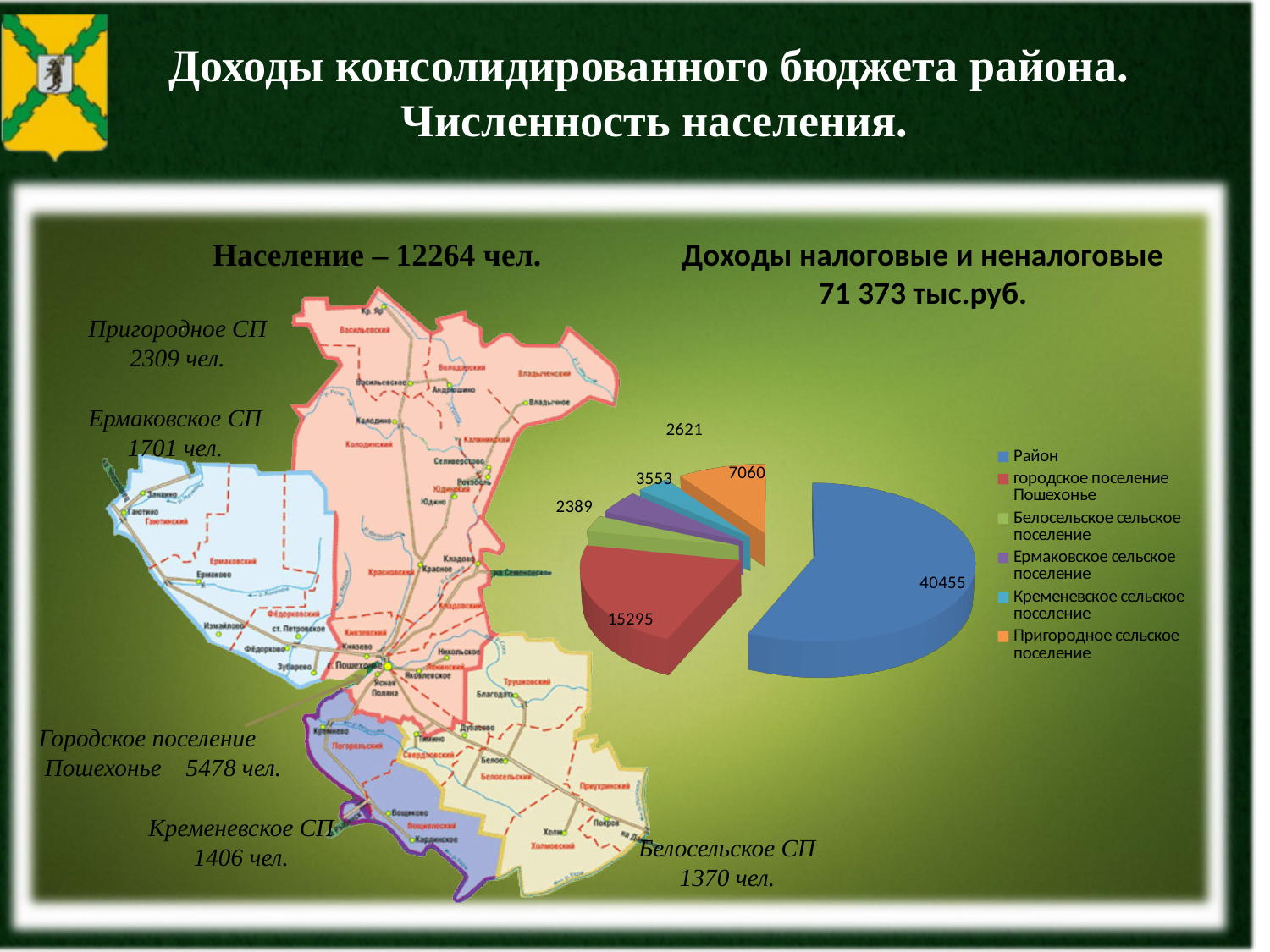
What is the value for городское поселение Пошехонье in the pie chart? 15295 Which is larger: the value for Кременевское сельское поселение or Белосельское сельское поселение? Кременевское сельское поселение Which category has the smallest slice in the pie chart? Белосельское сельское поселение What is the value for Район in the pie chart? 40455 How many slices does the pie chart have? 6 How many entries does the legend of the pie chart list? 6 Which category has the largest slice in the pie chart? Район What is the value for Пригородное сельское поселение in the pie chart? 7060 What is the difference between the values for Район and городское поселение Пошехонье? 25160 What is the title shown above the pie chart? Доходы налоговые и неналоговые 71 373 тыс.руб. What kind of chart is shown on the slide? pie chart What is the value for Ермаковское сельское поселение in the pie chart? 3553